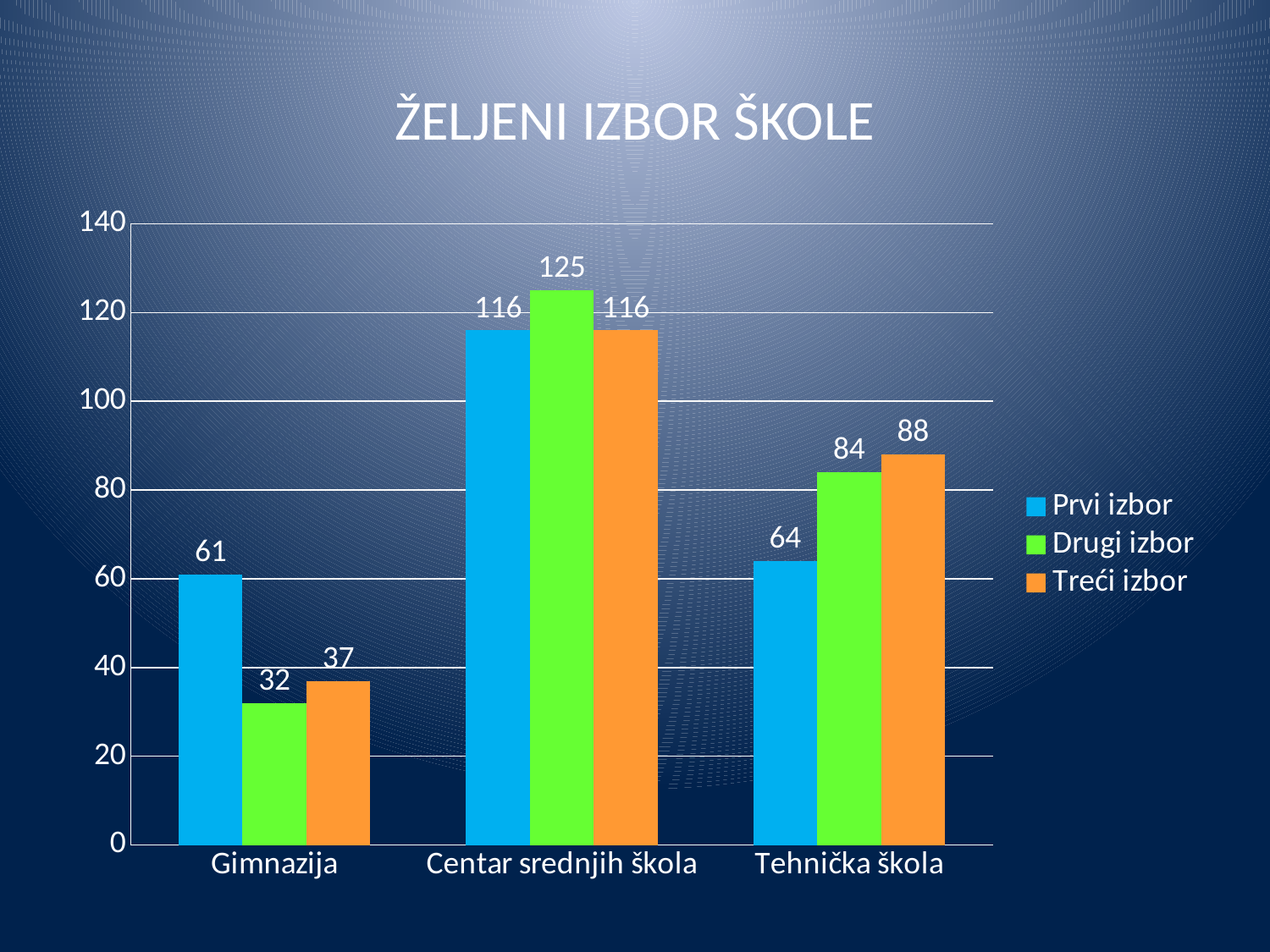
What is the value of Prvi izbor for Gimnazija? 61 How many categories are shown on the x axis? 3 What is the difference between the Drugi izbor and Prvi izbor values for Centar srednjih škola? 9 What is the value of Drugi izbor for Centar srednjih škola? 125 Which category has the highest Prvi izbor value? Centar srednjih škola What kind of chart is shown on the slide? bar chart Which is larger for Tehnička škola: Prvi izbor or Drugi izbor? Drugi izbor How many series does the legend list? 3 Is the Treći izbor value for Gimnazija greater or less than 40? less What is the value of Treći izbor for Tehnička škola? 88 Which category has the lowest Drugi izbor value? Gimnazija What is the title of the chart? ŽELJENI IZBOR ŠKOLE